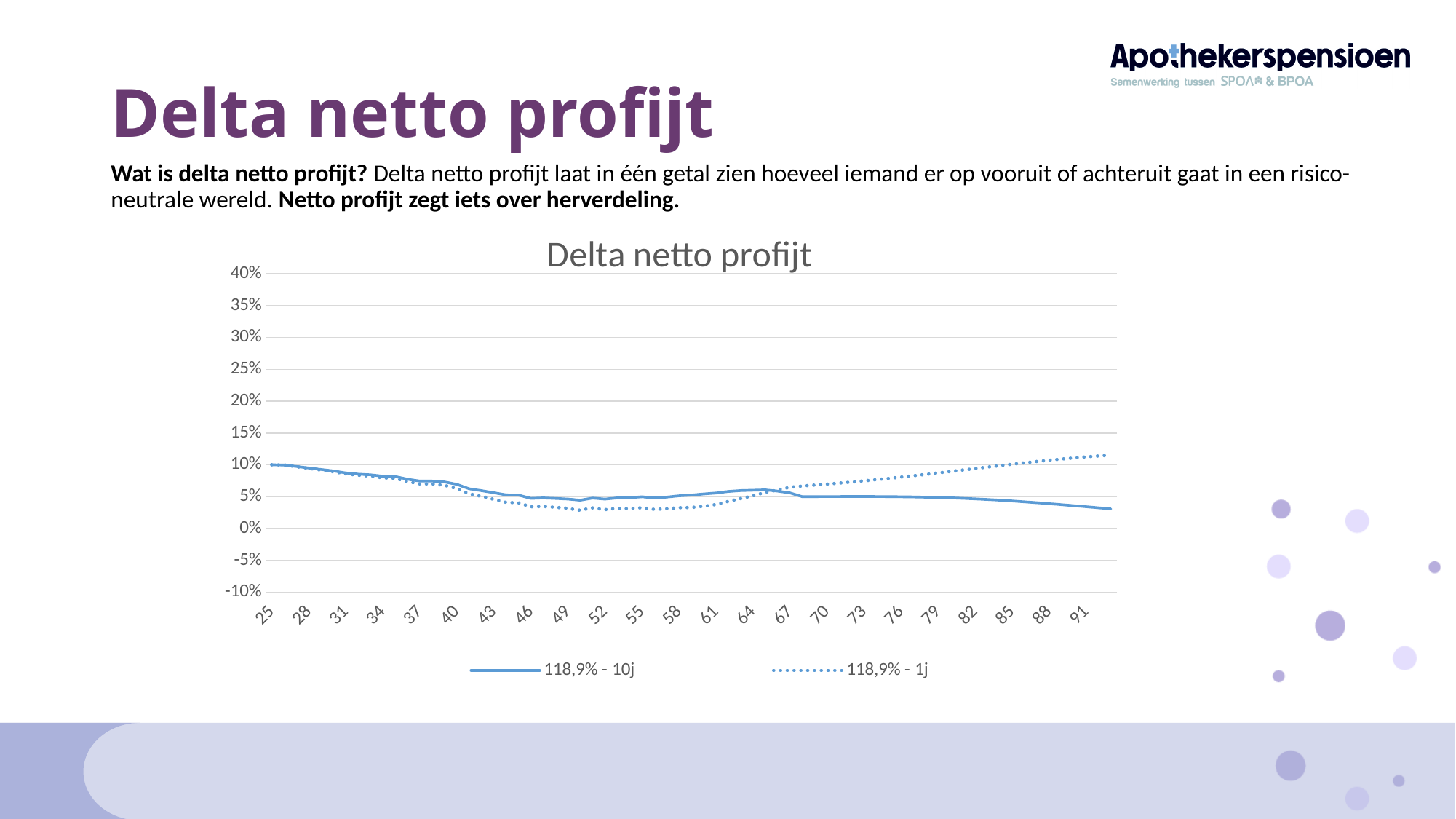
Is the value of the '118,9% - 1j' series at age 91 greater or less than 10%? greater Which series is drawn with a dotted line in the chart? 118,9% - 1j Is the value of the '118,9% - 10j' series at age 40 greater or less than 5%? greater Is the value of the '118,9% - 1j' series at age 52 greater or less than 5%? less Does the '118,9% - 1j' series rise or fall between age 52 and age 91? rise What kind of chart is shown on the slide? line chart At age 91, which series has the higher value: '118,9% - 10j' or '118,9% - 1j'? 118,9% - 1j How many series does the legend of the chart list? 2 At age 49, which series has the higher value: '118,9% - 10j' or '118,9% - 1j'? 118,9% - 10j What is the title of the chart? Delta netto profijt Does the '118,9% - 10j' series rise or fall between age 67 and age 91? fall